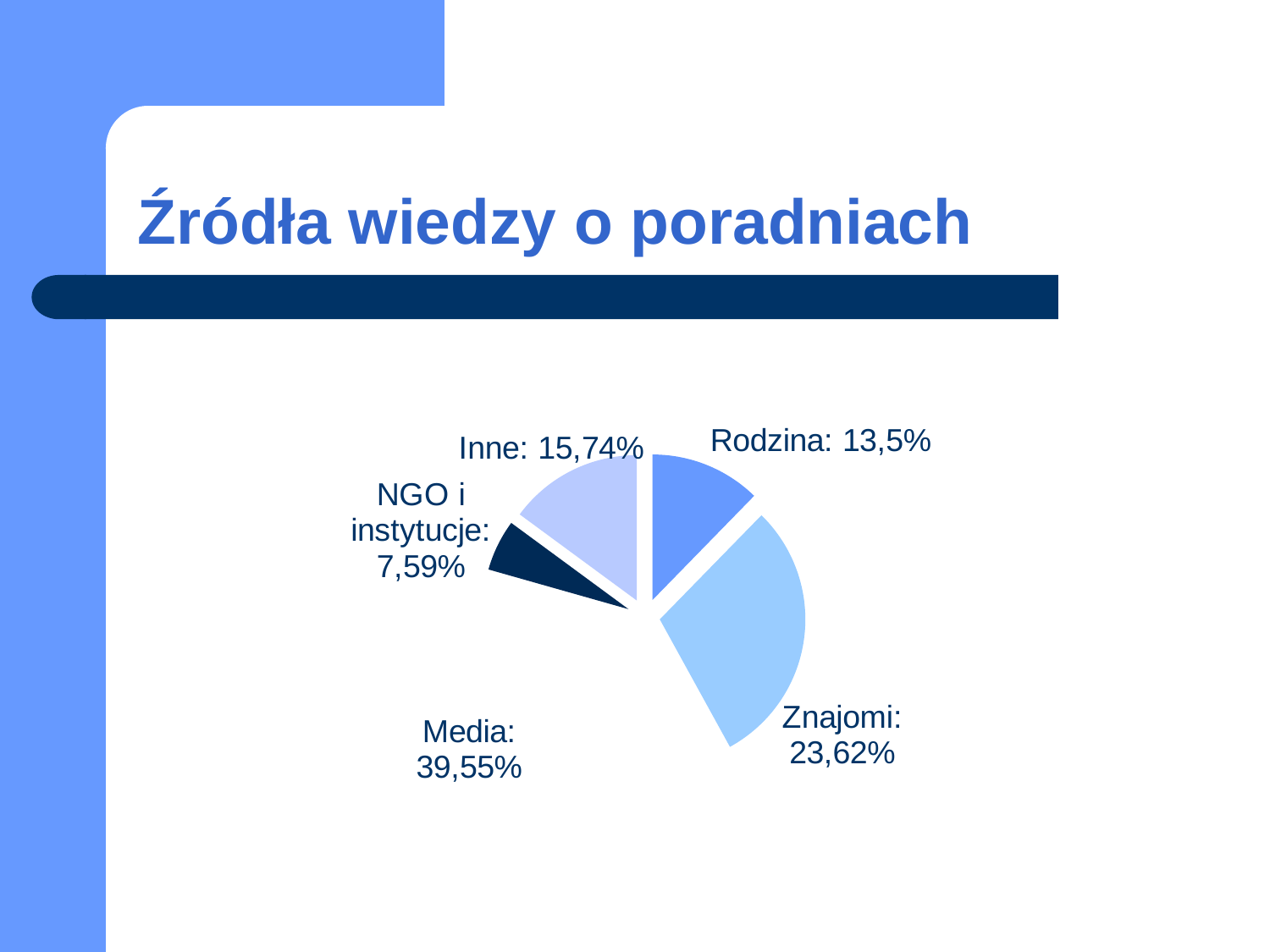
Which category has the smallest share of the pie? NGO i instytucje What is the value for NGO i instytucje? 7,59% Which is larger, the share for Inne or the share for Rodzina? Inne What share is shown for Inne? 15,74% What is the title of the slide containing the chart? Źródła wiedzy o poradniach How many categories are shown in the pie chart? 5 Which category has the largest share of the pie? Media What type of chart is shown on the slide? Pie chart What is the difference between the shares for Media and Znajomi? 15,93% What share of the pie does Media account for? 39,55% What percentage is labelled for Rodzina? 13,5% What is the value shown for Znajomi? 23,62%